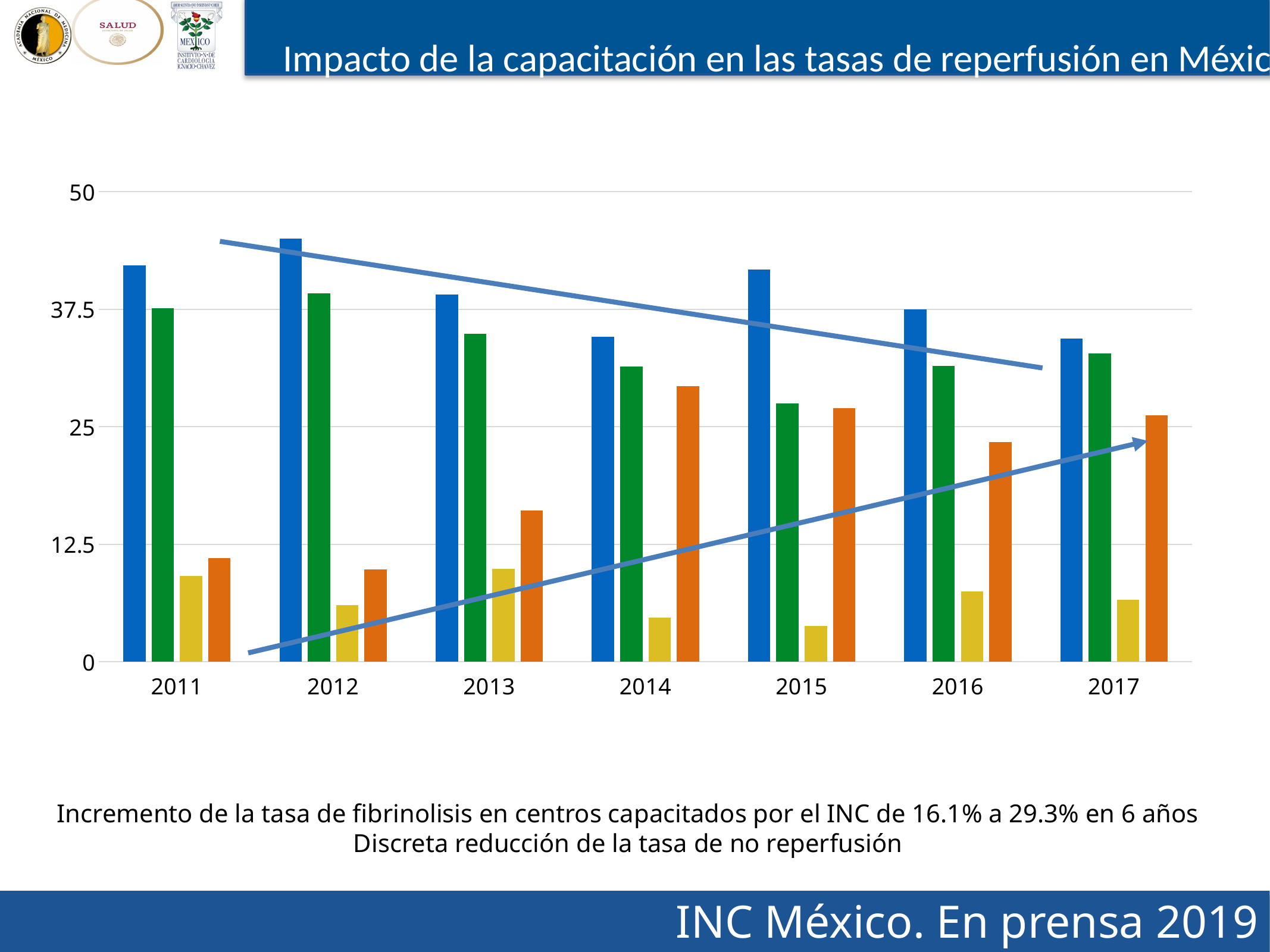
What kind of chart is shown on the slide? bar chart How many years are shown along the x axis of the chart? 7 Is the value of the blue bar for 2014 greater or less than 37.5? less How many bars are plotted for each year in the chart? 4 In which year is the blue bar the tallest? 2012 Is the value of the yellow bar for 2015 greater or less than 12.5? less Do the orange bars generally rise or fall from 2011 to 2017? rise In 2014, which bar is taller, the orange bar or the yellow bar? orange What is the highest value shown on the y axis of the chart? 50 Is the value of the blue bar for 2012 greater or less than 37.5? greater